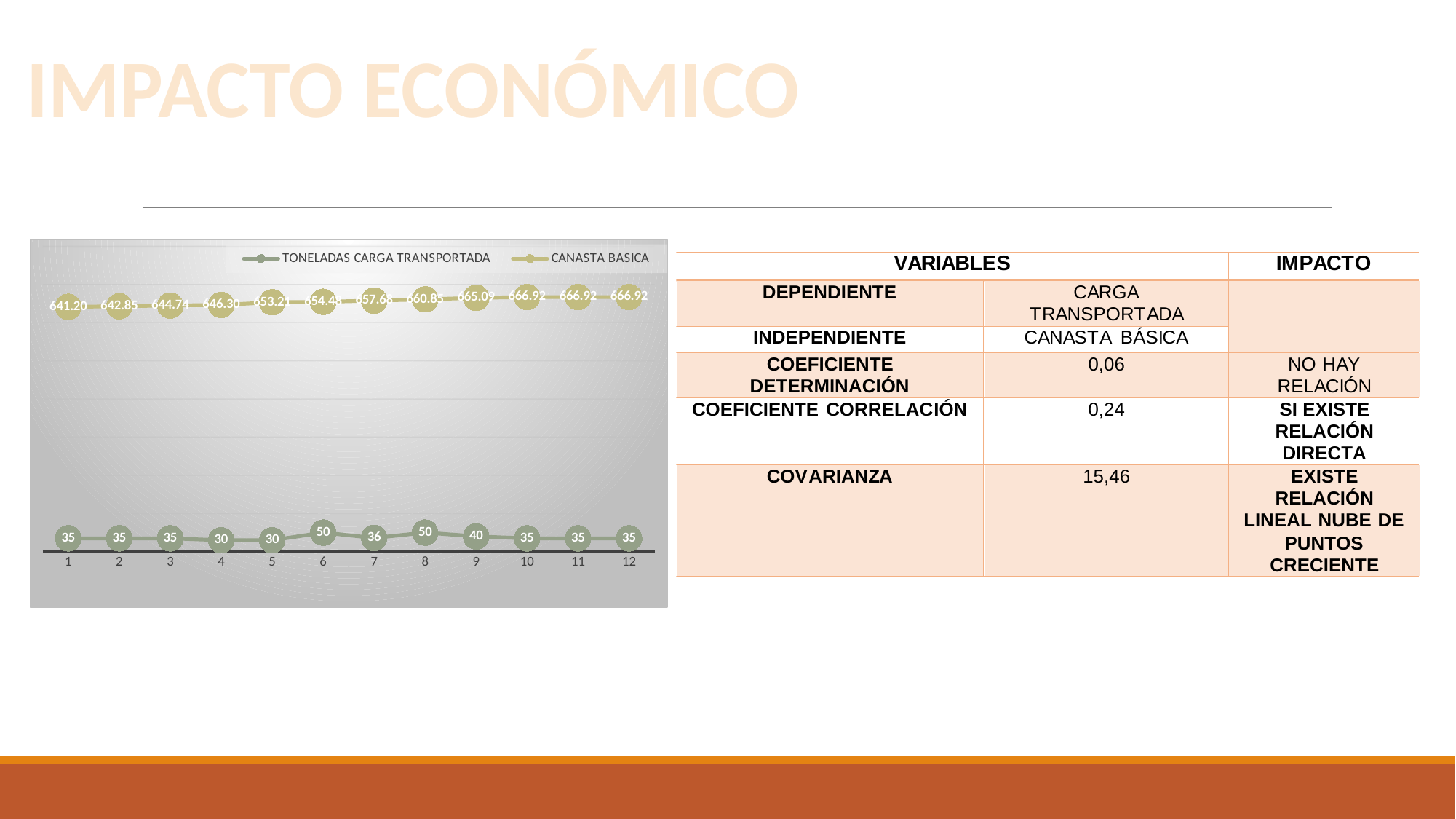
What is the highest value of CANASTA BASICA shown on the chart? 666.92 What is the value of CANASTA BASICA at point 1? 641.20 How many points are plotted along the x axis for each series? 12 Does the CANASTA BASICA series generally rise or fall from point 1 to point 12? rise What is the value of TONELADAS CARGA TRANSPORTADA at point 6? 50 What is the value of CANASTA BASICA at point 9? 665.09 How many series does the chart legend list? 2 What is the difference between the TONELADAS CARGA TRANSPORTADA values at point 8 and point 7? 14 What are the two series names shown in the chart legend? TONELADAS CARGA TRANSPORTADA and CANASTA BASICA Which is larger: the TONELADAS CARGA TRANSPORTADA value at point 9 or at point 10? point 9 What is the lowest value of TONELADAS CARGA TRANSPORTADA shown on the chart? 30 What type of chart is shown on the slide? line chart